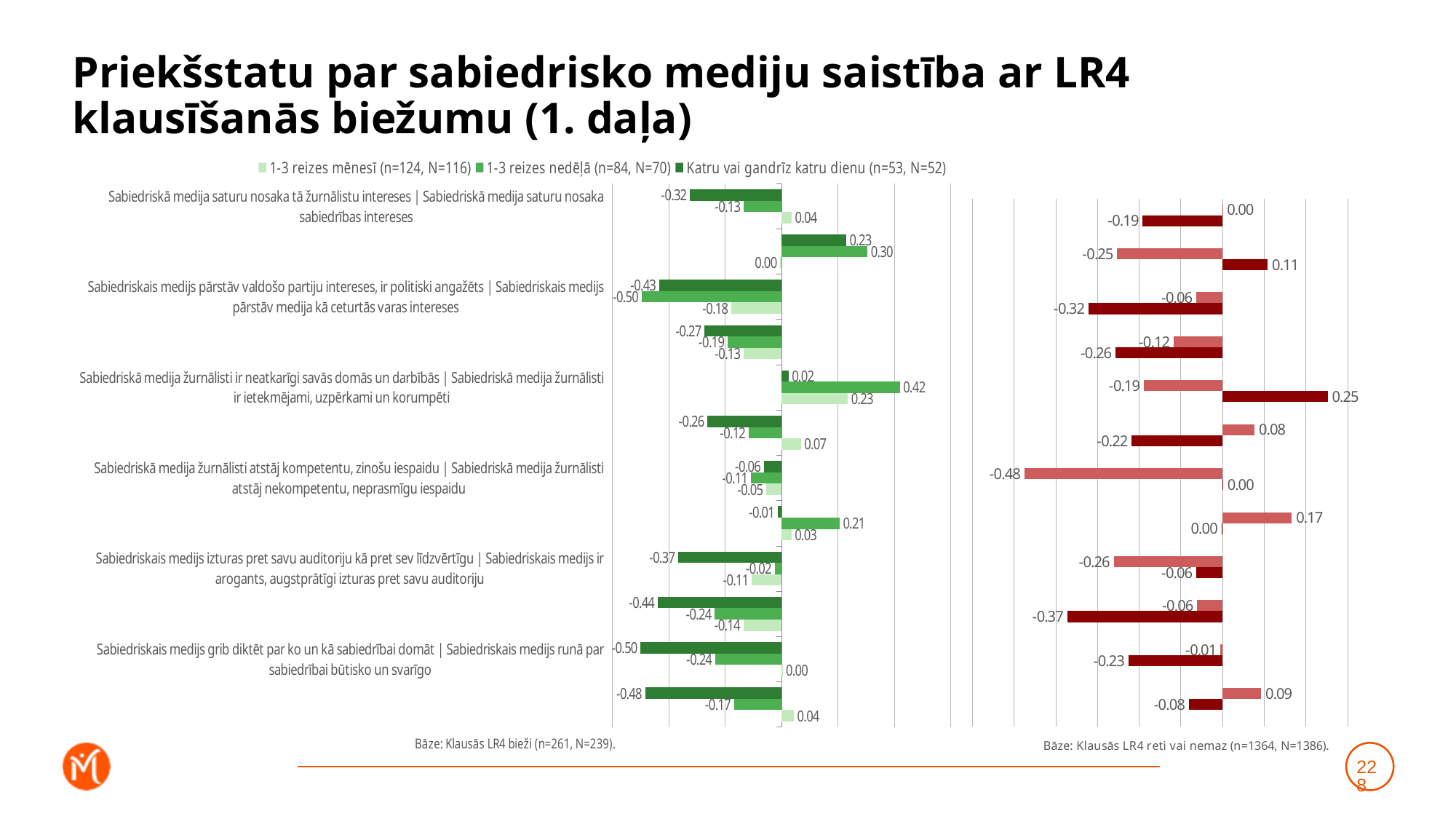
What kind of chart is the left (green) chart on the slide? bar chart How many groups of bars does the right (red) chart contain? 12 In the left (green) chart, what is the value of the 'Katru vai gandrīz katru dienu' series for the statement 'Sabiedriskā medija saturu nosaka tā žurnālistu intereses | Sabiedriskā medija saturu nosaka sabiedrības intereses'? -0.32 In the left (green) chart, for the statement 'Sabiedriskā medija žurnālisti ir neatkarīgi savās domās un darbībās | ...', which series has the larger value: '1-3 reizes nedēļā' or '1-3 reizes mēnesī'? 1-3 reizes nedēļā In the left (green) chart, for the statement 'Sabiedriskā medija žurnālisti ir neatkarīgi savās domās un darbībās | ...', what is the difference between the '1-3 reizes nedēļā' value (0.42) and the '1-3 reizes mēnesī' value (0.23)? 0.19 How many series does the legend of the left (green) chart list? 3 In the left (green) chart, what is the highest value shown by any bar? 0.42 What base (Bāze) text is shown beneath the left (green) chart? Bāze: Klausās LR4 bieži (n=261, N=239). In the left (green) chart, what is the lowest value shown by any bar? -0.50 In the right (red) chart, what is the lowest value shown by any bar? -0.48 In the right (red) chart, what is the highest value shown by any bar? 0.25 In the left (green) chart, what is the value of the '1-3 reizes nedēļā' series for the statement 'Sabiedriskā medija žurnālisti ir neatkarīgi savās domās un darbībās | Sabiedriskā medija žurnālisti ir ietekmējami, uzpērkami un korumpēti'? 0.42